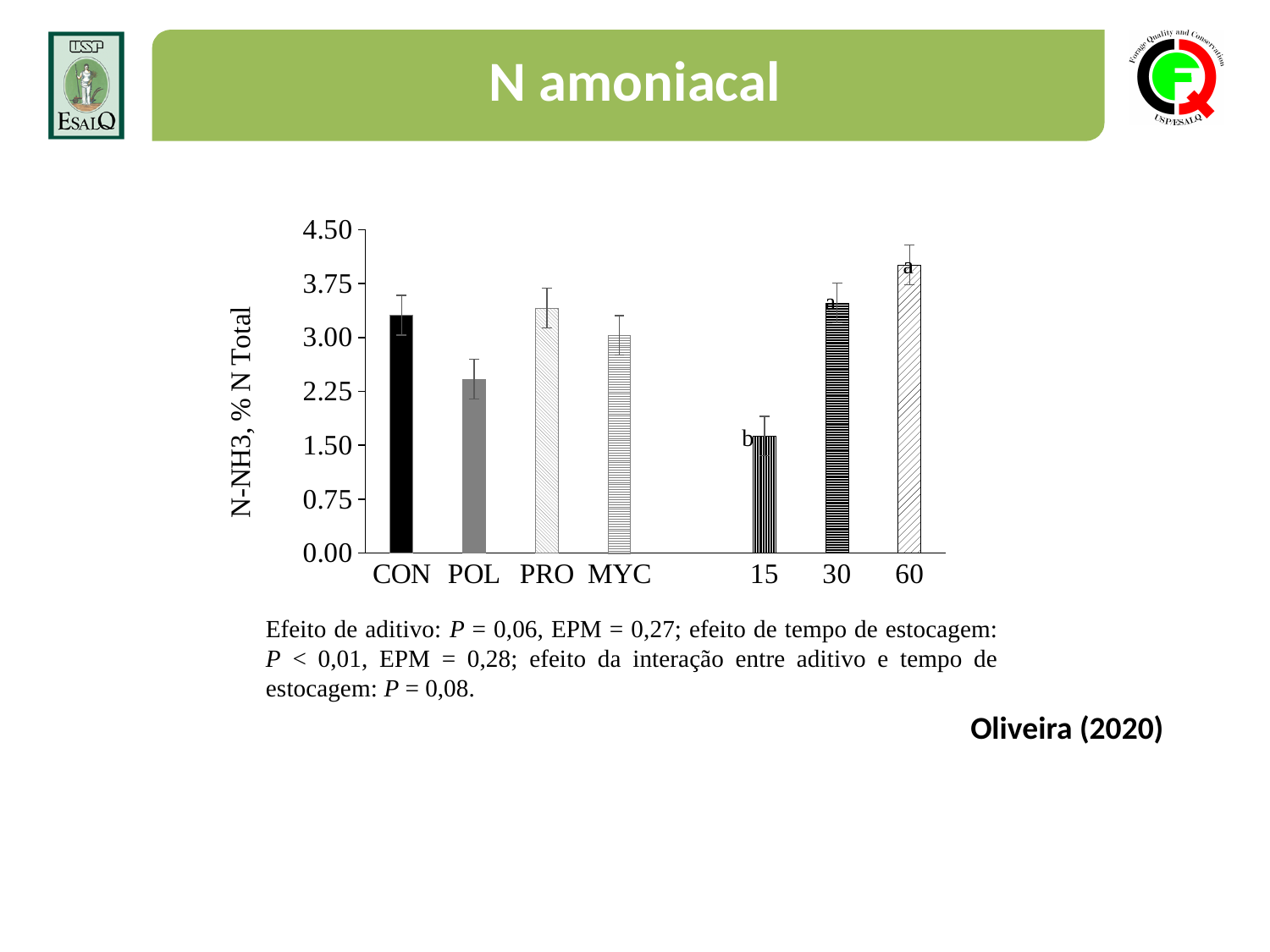
Which category has the highest N-NH3 value? 60 Is the value for 60 greater or less than 3.75? greater What is the label of the y axis? N-NH3, % N Total Which is larger, the value for CON or the value for POL? CON How many bars are plotted in the chart? 7 Which is larger, the value for 30 or the value for 15? 30 What kind of chart is shown on the slide? bar chart What is the title of the slide containing the chart? N amoniacal Is the value for 15 greater or less than 2.25? less Is the value for POL greater or less than 3.00? less Which category has the lowest N-NH3 value? 15